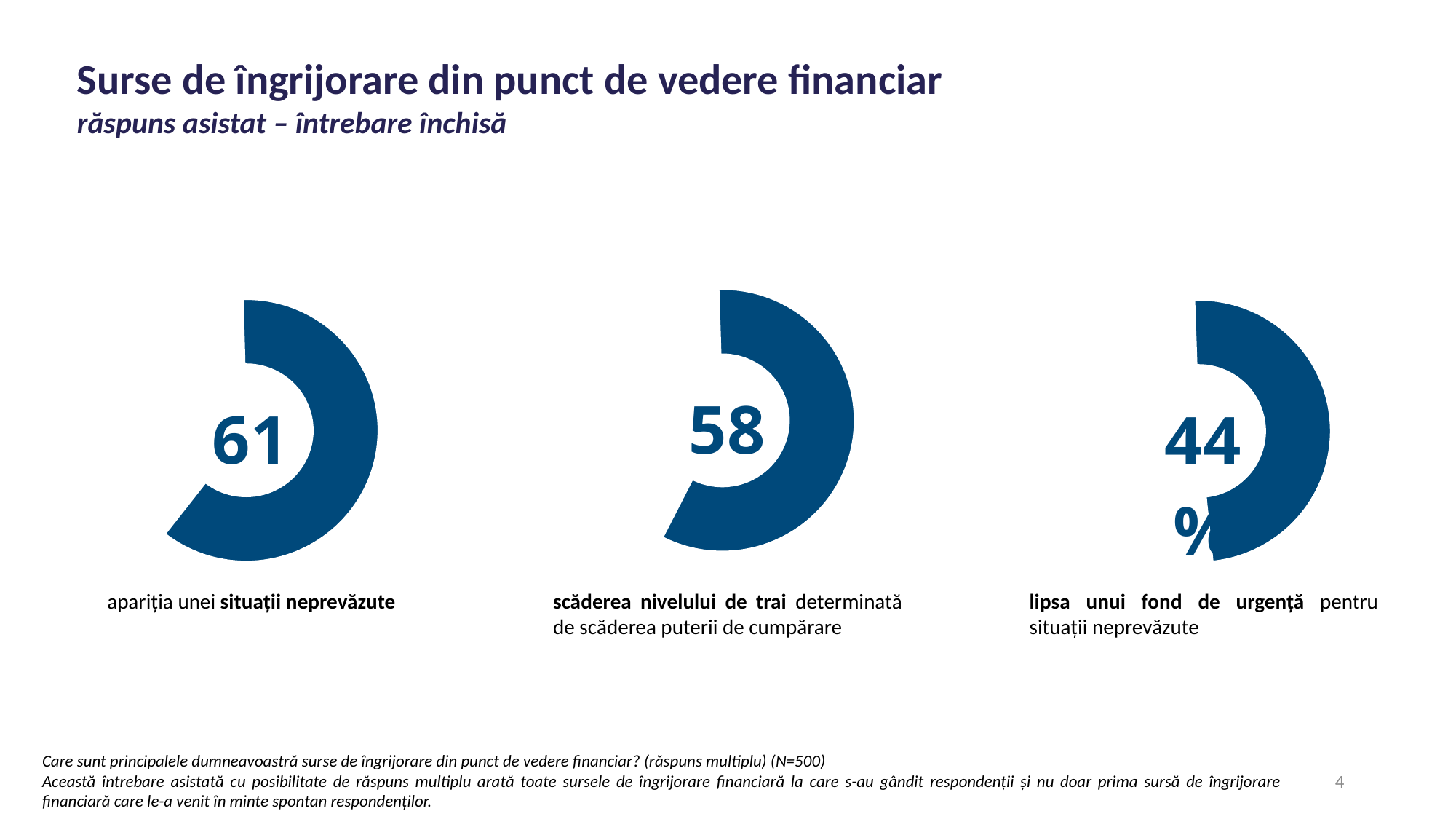
What value is shown in the middle doughnut chart, for 'scăderea nivelului de trai'? 58 What is the difference between the value for 'apariția unei situații neprevăzute' (61) and 'scăderea nivelului de trai' (58)? 3 What kind of chart is used to display each value on the slide? doughnut chart Which of the three sources of financial worry has the highest value? apariția unei situații neprevăzute What value is shown in the right doughnut chart, for 'lipsa unui fond de urgență'? 44% Which is larger: the value for 'scăderea nivelului de trai' or the value for 'lipsa unui fond de urgență'? scăderea nivelului de trai How many doughnut charts are shown on the slide? 3 What is the difference between the value for 'apariția unei situații neprevăzute' (61) and 'lipsa unui fond de urgență' (44)? 17 What value is shown in the left doughnut chart, for 'apariția unei situații neprevăzute'? 61 What colour are the filled segments of the doughnut charts? dark blue What is the main title of the slide? Surse de îngrijorare din punct de vedere financiar Which of the three sources of financial worry has the lowest value? lipsa unui fond de urgență pentru situații neprevăzute